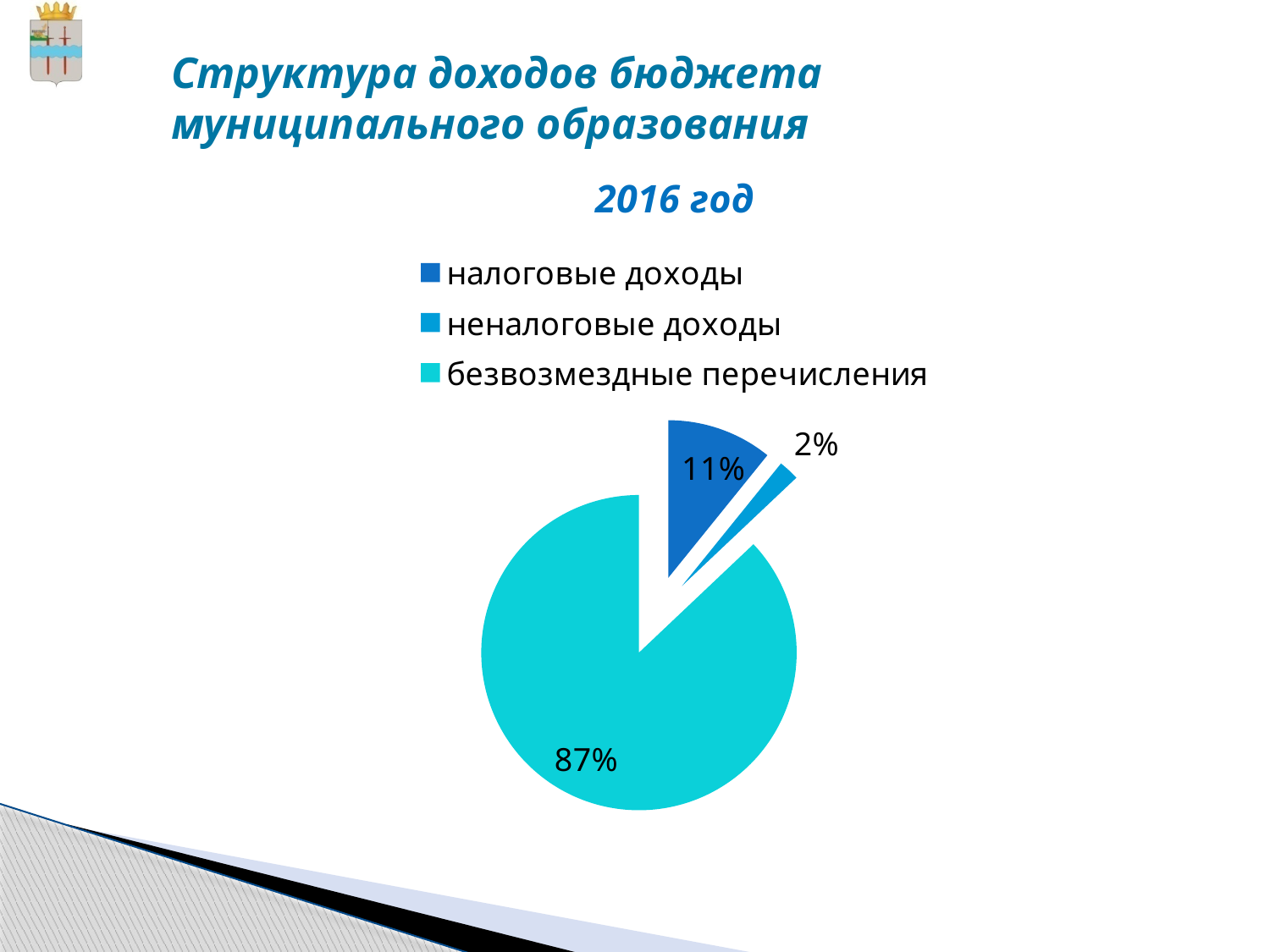
What kind of chart is shown on the slide? pie chart Which category has the smallest slice of the pie? неналоговые доходы What is the difference in percentage points between безвозмездные перечисления and налоговые доходы? 76 Which is larger, налоговые доходы or неналоговые доходы? налоговые доходы How many slices does the pie chart have? 3 Which category has the largest slice of the pie? безвозмездные перечисления What share of the pie does безвозмездные перечисления have? 87% What is the title of the chart? 2016 год How many entries does the legend list? 3 What share of the pie does налоговые доходы have? 11% What share of the pie does неналоговые доходы have? 2% What is the difference in percentage points between налоговые доходы and неналоговые доходы? 9